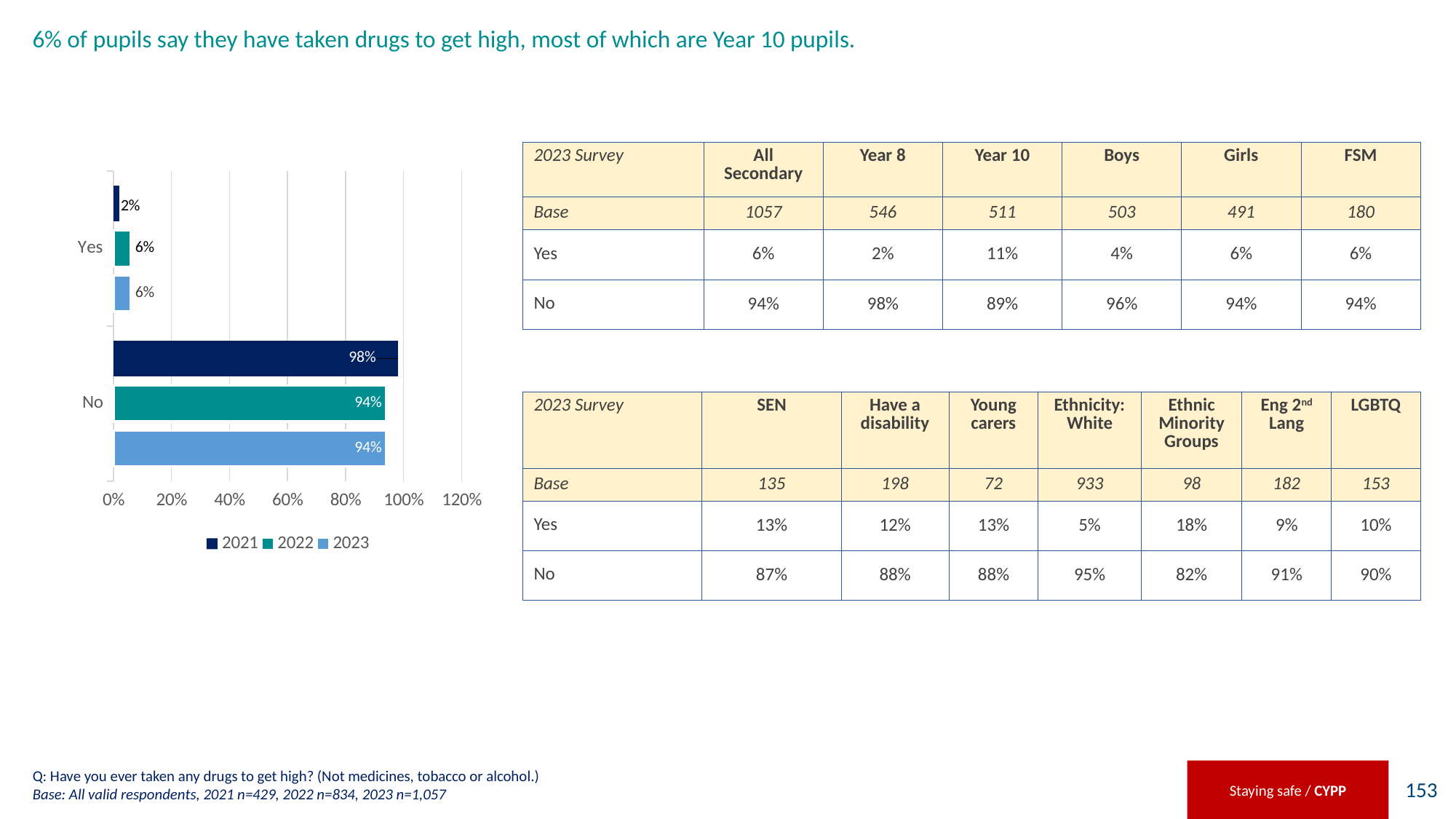
How many categories are shown on the chart's vertical axis? 2 What is the value for 'No' in 2021? 98% What kind of chart is shown on the slide? Bar chart What is the value for 'Yes' in 2021? 2% What is the difference between the 'Yes' values for 2022 and 2021? 4% How many series does the chart legend list? 3 What is the value for 'No' in 2023? 94% Which year has the lowest value for 'Yes'? 2021 Which year has the highest value for 'No'? 2021 Which series is shown in the darkest blue colour in the legend? 2021 Which is larger: the 'No' value for 2021 or for 2022? 2021 What is the value for 'Yes' in 2022? 6%